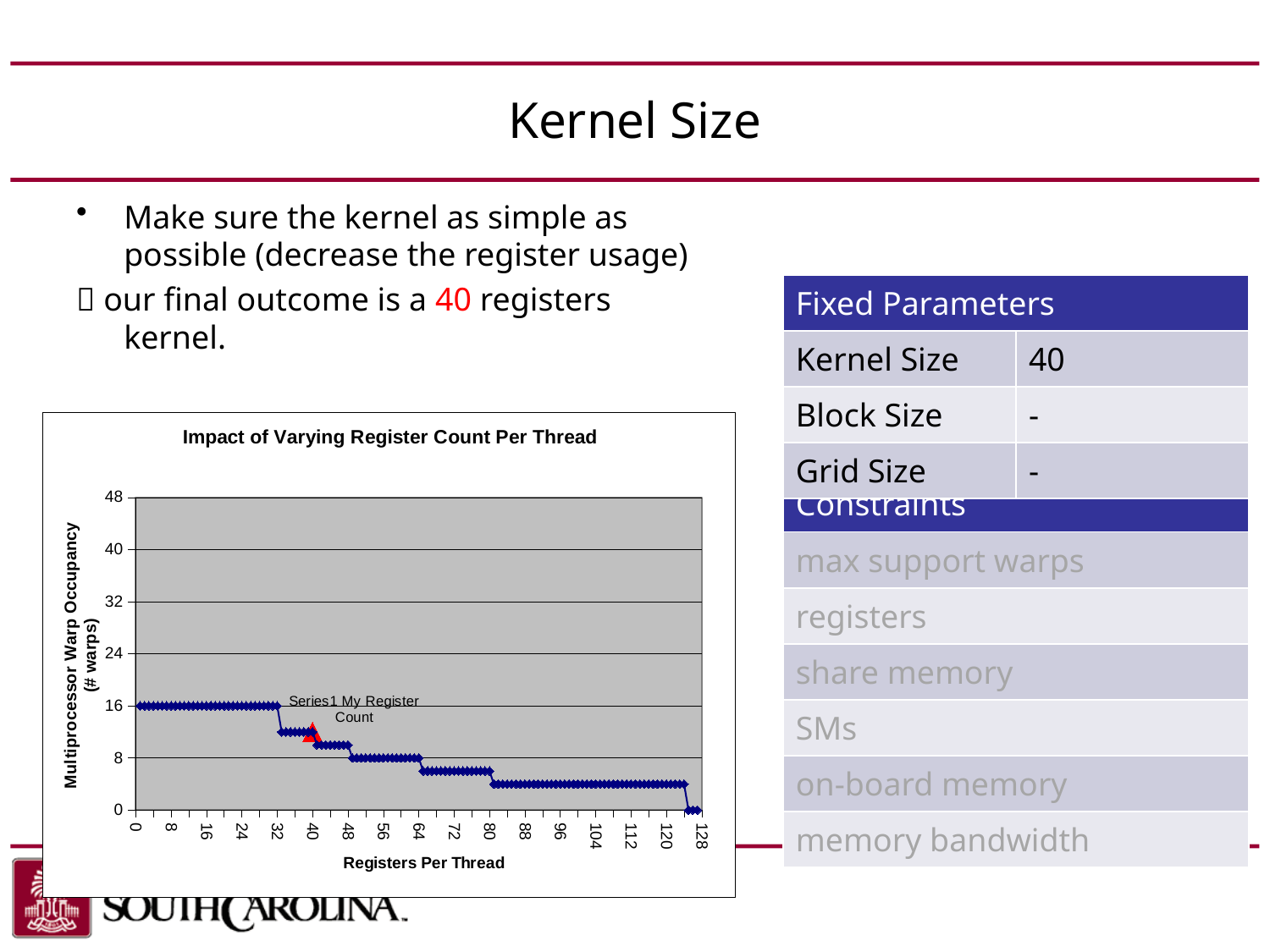
What kind of chart is shown on the slide? line chart Does the warp occupancy rise or fall as registers per thread increase along the x axis? fall Is the warp occupancy at 100 registers per thread greater or less than 8? less At what register count is the 'My Register Count' marker placed on the chart? 40 Is the warp occupancy at 24 registers per thread greater or less than 8? greater Is the warp occupancy at 72 registers per thread greater or less than 8? less Which has the higher warp occupancy: 8 registers per thread or 88 registers per thread? 8 registers per thread What is the label of the x axis of the chart? Registers Per Thread What is the multiprocessor warp occupancy at 56 registers per thread? 8 What is the title of the chart? Impact of Varying Register Count Per Thread What is the multiprocessor warp occupancy at 16 registers per thread? 16